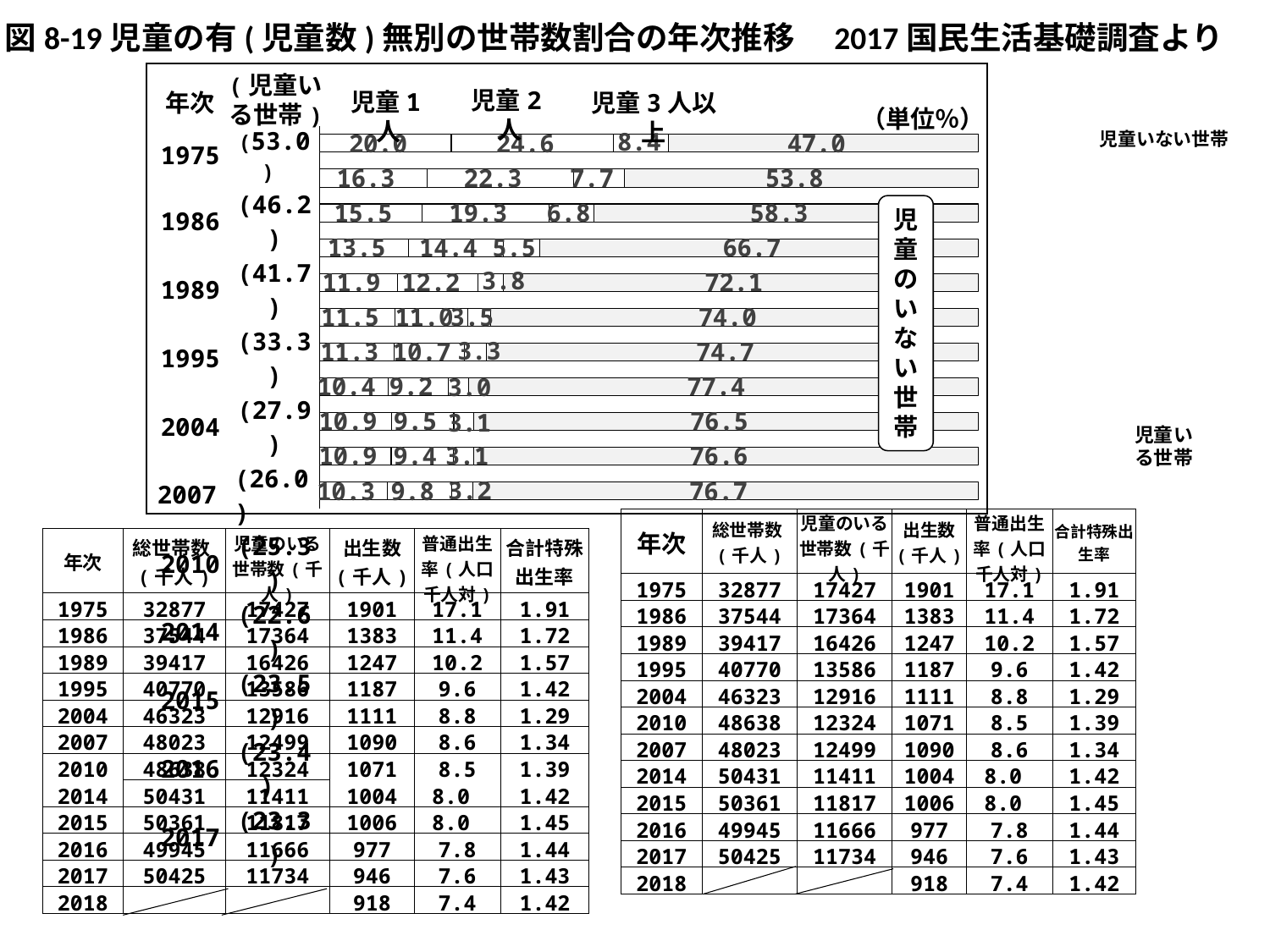
In the bottommost bar, what is the value for 児童1人? 10.3 How many bars (years) are plotted in the chart? 11 How many series (segments) make up each bar in the chart? 4 In the topmost bar (1975), which is larger, the 児童1人 segment or the 児童2人 segment? 児童2人 What unit is indicated for the values in the chart? % What kind of chart is shown on the slide? bar chart In the topmost bar (1975), what is the value for 児童3人以上? 8.4 What is the highest 児童いない世帯 value shown in the chart? 77.4 Do the 児童いない世帯 values generally rise or fall going from the top bar to the bottom bar? rise What is the difference between the 児童1人 value in the topmost bar (20.0) and in the bottommost bar (10.3)? 9.7 In the topmost bar (1975), what is the value for 児童いない世帯? 47.0 What is the lowest 児童いない世帯 value shown in the chart? 47.0